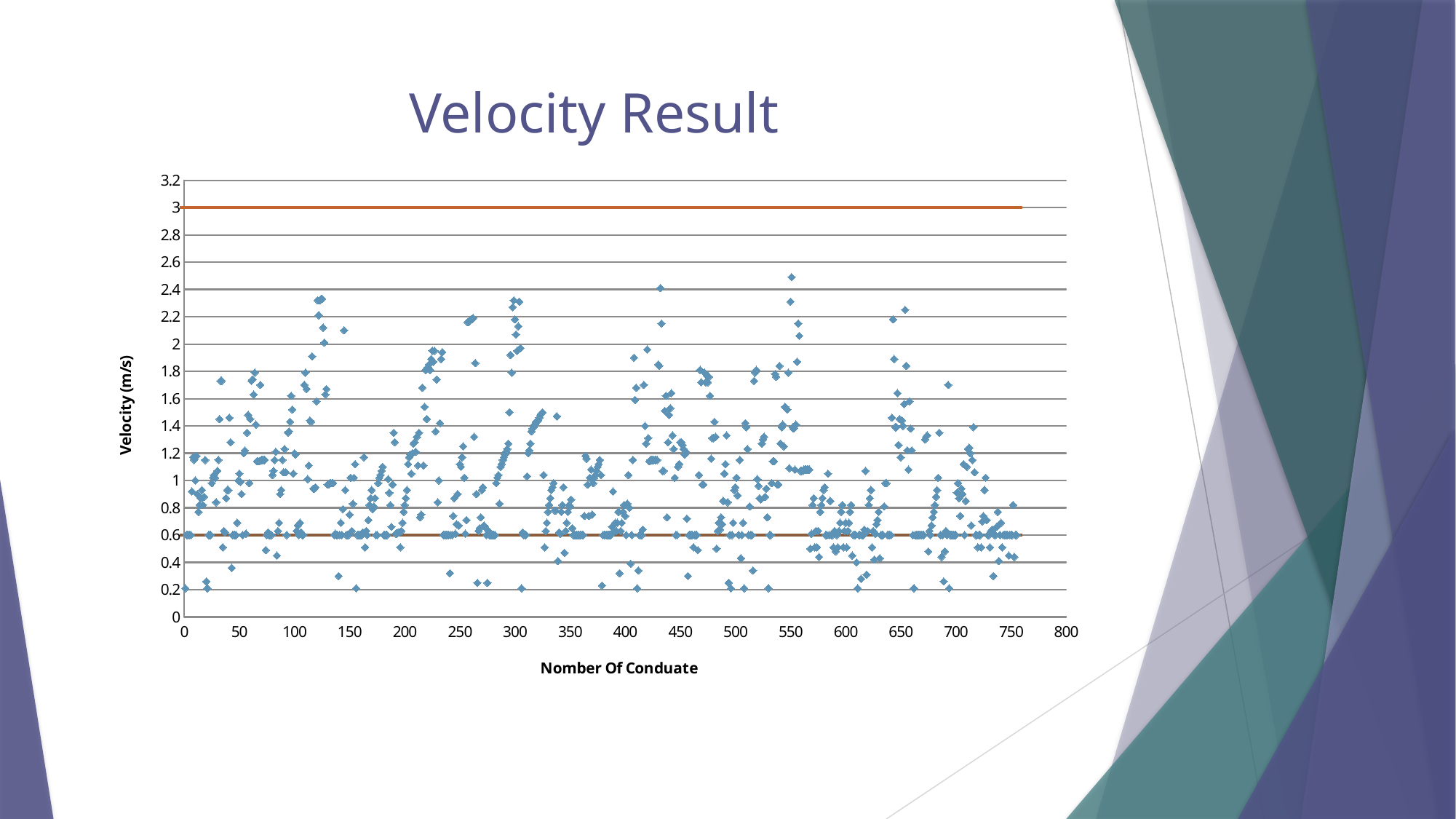
Is the lowest plotted velocity point greater or less than 0.4? less How many horizontal orange reference lines are drawn on the chart? 2 Is the highest plotted velocity point greater or less than 2.4? greater Do any plotted points reach the upper orange line at 3? no What is the title of the chart? Velocity Result At what velocity value is the upper horizontal orange line drawn? 3 What is the label of the vertical axis? Velocity (m/s) At what velocity value is the lower horizontal orange line drawn? 0.6 What kind of chart is shown on the slide? scatter chart What is the maximum value shown on the horizontal axis? 800 What is the maximum value shown on the vertical axis? 3.2